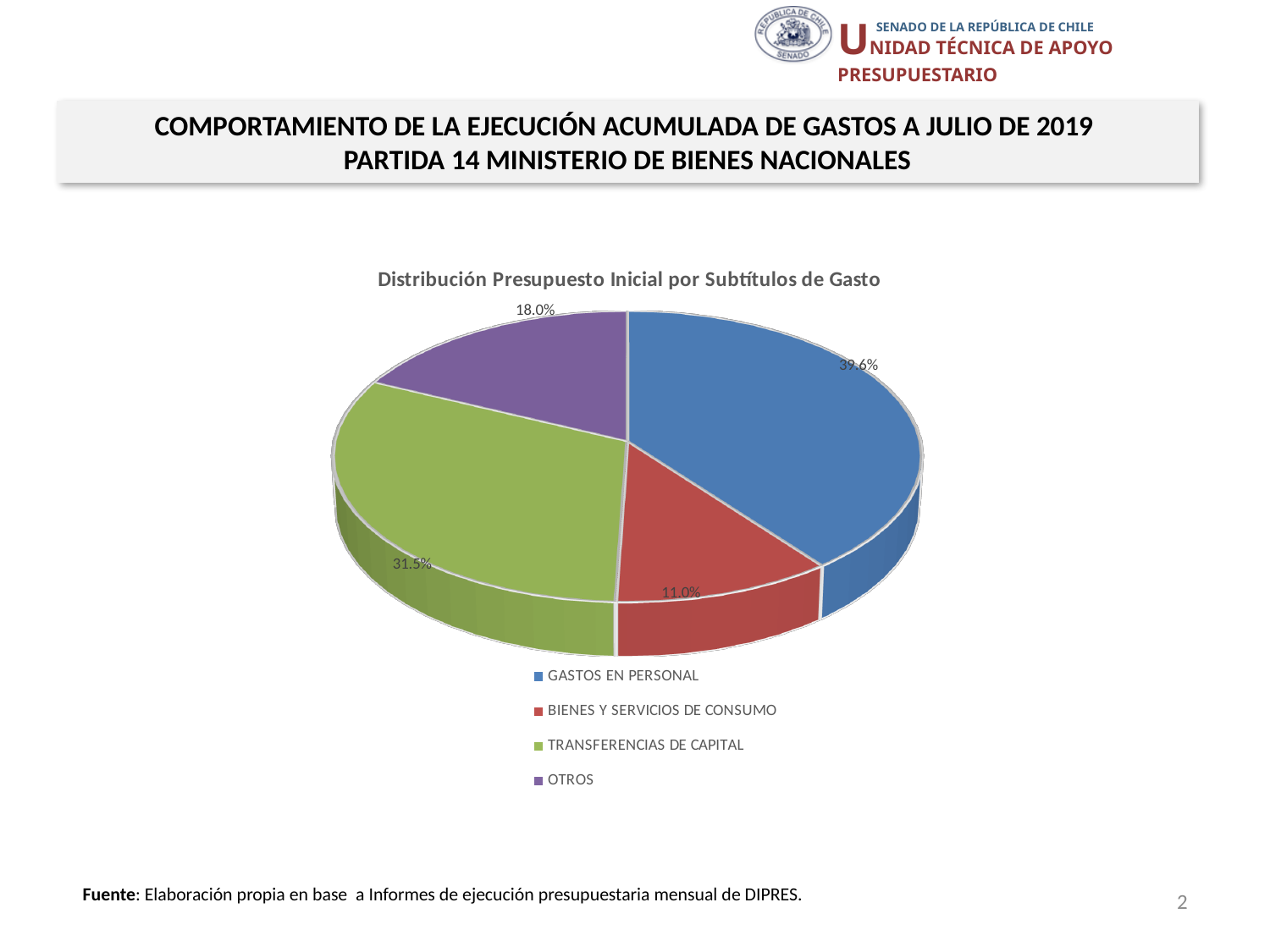
What share of the pie does TRANSFERENCIAS DE CAPITAL represent? 31.5% What share of the pie does OTROS represent? 18.0% Which category has the largest slice of the pie? GASTOS EN PERSONAL Which category has the smallest slice of the pie? BIENES Y SERVICIOS DE CONSUMO What colour is the slice for TRANSFERENCIAS DE CAPITAL? Green What share of the pie does BIENES Y SERVICIOS DE CONSUMO represent? 11.0% Which is larger, the share for OTROS or the share for BIENES Y SERVICIOS DE CONSUMO? OTROS What is the title of the chart? Distribución Presupuesto Inicial por Subtítulos de Gasto How many categories are shown in the pie chart? 4 What is the difference in percentage points between GASTOS EN PERSONAL and TRANSFERENCIAS DE CAPITAL? 8.1 What type of chart is shown on the slide? Pie chart